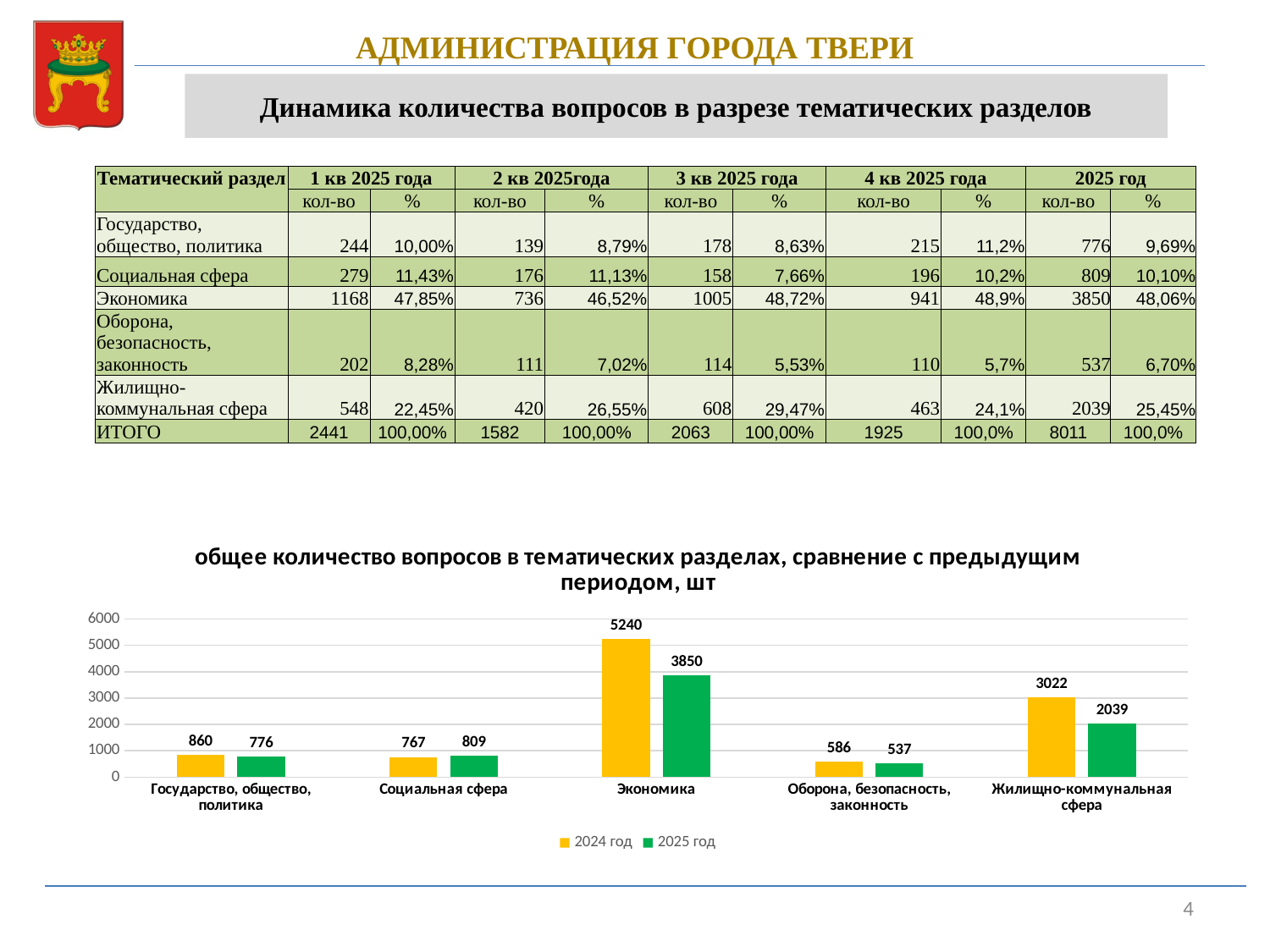
How many series does the chart legend list? 2 What is the value for Социальная сфера in the 2024 год series? 767 Which category has the lowest value in the 2024 год series? Оборона, безопасность, законность What is the difference between the 2024 год and 2025 год values for Экономика? 1390 What is the value for Экономика in the 2024 год series? 5240 Which colour represents the 2025 год series in the chart? green What is the difference between the 2024 год and 2025 год values for Жилищно-коммунальная сфера? 983 What is the value for Жилищно-коммунальная сфера in the 2025 год series? 2039 What kind of chart is shown on the slide? bar chart How many categories are shown on the x axis of the chart? 5 Which is larger for Социальная сфера: the 2024 год value or the 2025 год value? 2025 год Which category has the highest value in the 2025 год series? Экономика